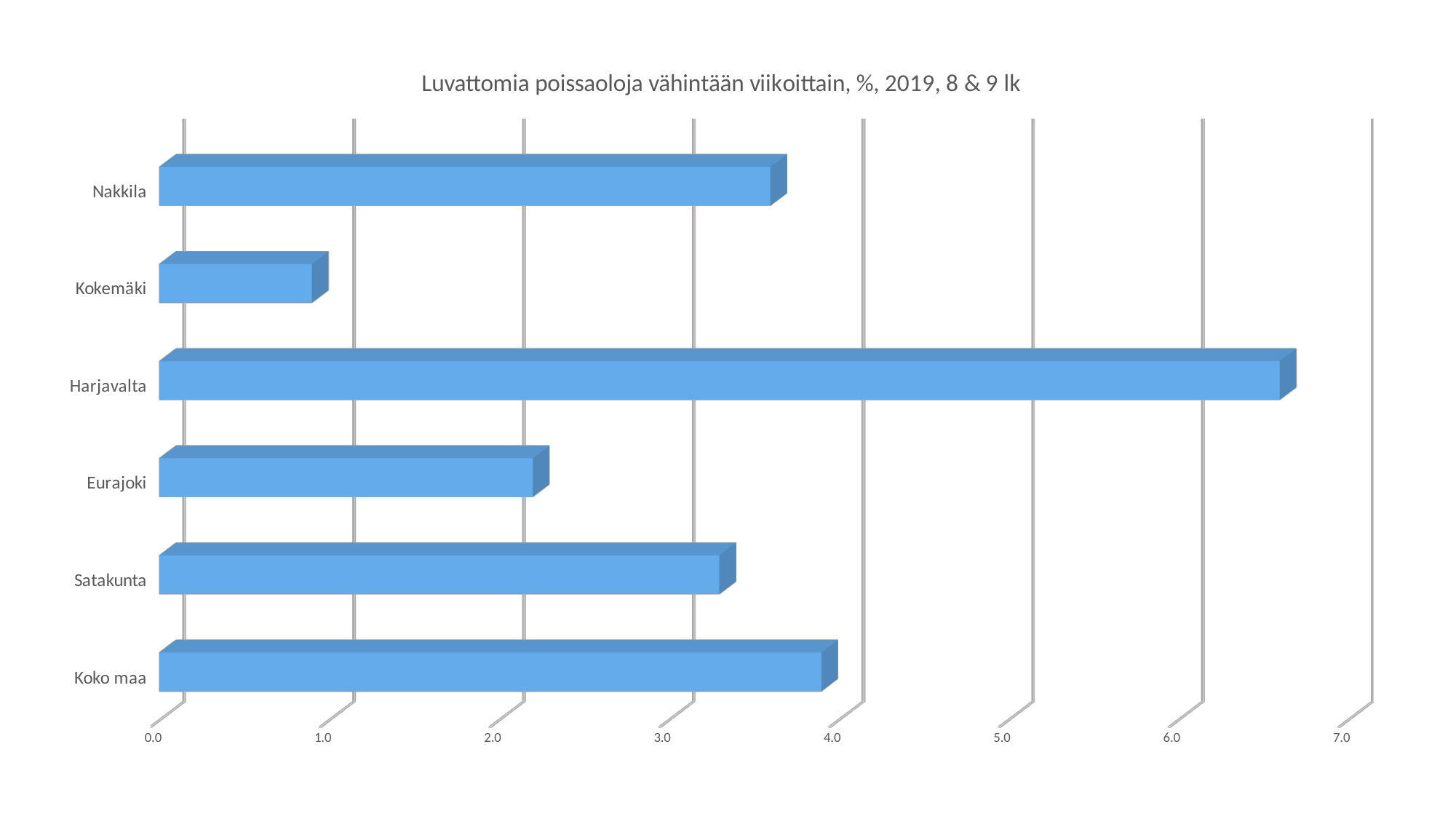
Which category has the lowest value? Kokemäki Is the value for Kokemäki greater or less than 2.0? less What kind of chart is shown on the slide? bar chart Is the value for Koko maa greater or less than 3.0? greater What is the title of the chart? Luvattomia poissaoloja vähintään viikoittain, %, 2019, 8 & 9 lk Which has a larger value, Harjavalta or Nakkila? Harjavalta Which category has the highest value? Harjavalta How many categories are plotted in the chart? 6 Is the value for Eurajoki greater or less than 3.0? less Which has a larger value, Eurajoki or Kokemäki? Eurajoki